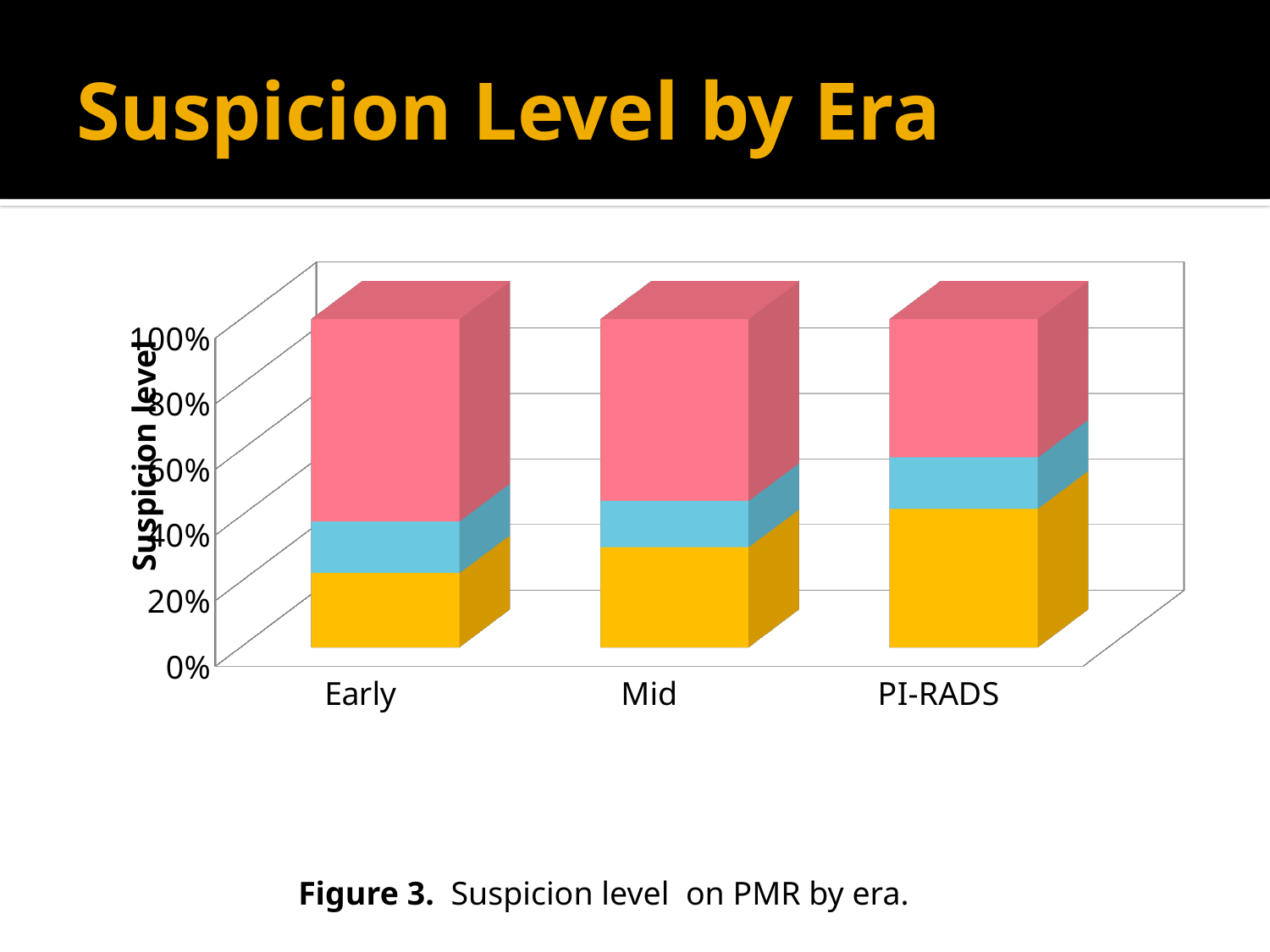
Is the top of the yellow segment for Early greater or less than 40%? less Is the yellow segment larger for Early or for PI-RADS? PI-RADS What kind of chart is shown on the slide? Stacked bar chart Which category has the largest pink segment? Early How many categories (eras) are shown on the x axis of the chart? 3 Does the yellow (bottom) segment of the bars rise or fall from Early to PI-RADS? Rise What is the title of the vertical axis of the chart? Suspicion level Which category has the smallest yellow segment? Early Does the pink (top) segment of the bars rise or fall from Early to PI-RADS? Fall Is the pink segment larger for Early or for PI-RADS? Early Is the top of the yellow segment for PI-RADS greater or less than 20%? greater What are the three categories on the x axis of the chart? Early, Mid, PI-RADS